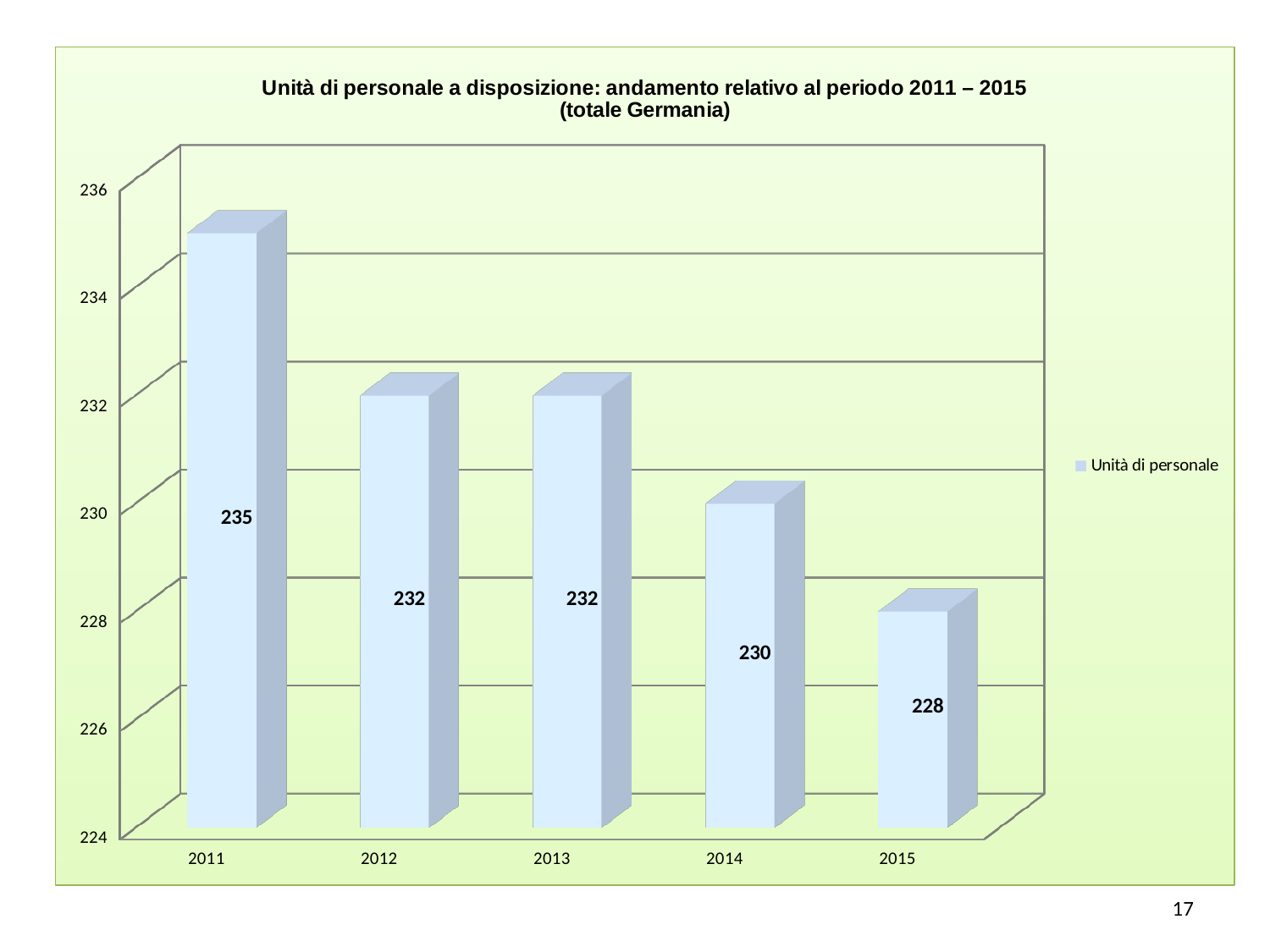
What is the value for 2014? 230 Which year has the highest value? 2011 Do the values rise or fall from 2011 to 2015? fall What is the value for 2015? 228 Which year has the lowest value? 2015 How many series does the legend list? 1 What is the value for 2011? 235 What is the difference between the values for 2011 and 2015? 7 Which is larger, the value for 2012 or the value for 2015? 2012 How many years are shown on the x axis? 5 What is the difference between the values for 2013 and 2014? 2 What kind of chart is this? bar chart